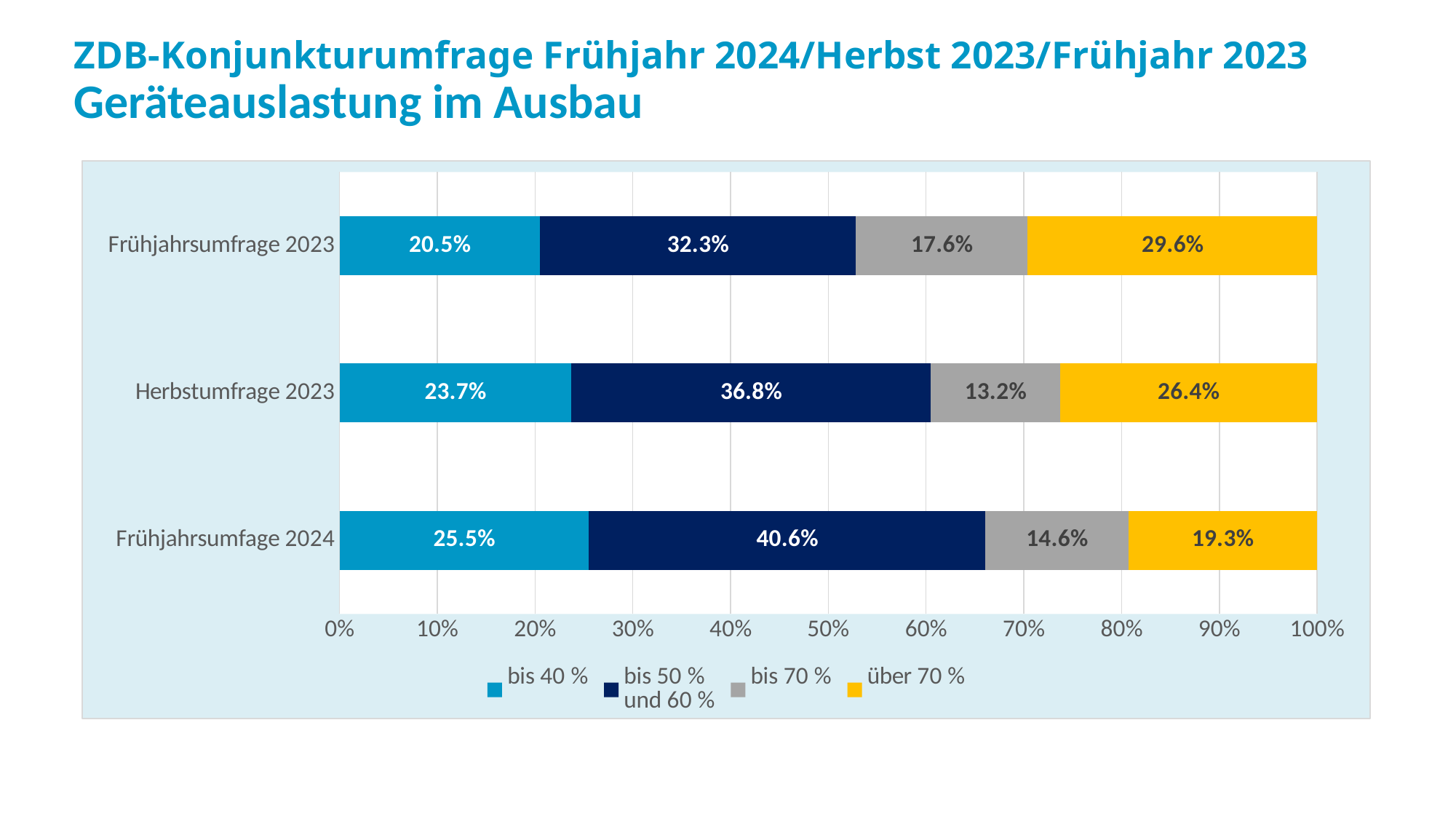
Which colour represents the 'über 70 %' series? Yellow How many surveys (bars) are shown in the chart? 3 What kind of chart is shown on the slide? Stacked bar chart What is the difference between the 'über 70 %' values for Frühjahrsumfrage 2023 and Frühjahrsumfage 2024? 10.3% Which is larger: the 'bis 40 %' value for Herbstumfrage 2023 or for Frühjahrsumfrage 2023? Herbstumfrage 2023 What is the value for 'bis 50 % und 60 %' in Herbstumfrage 2023? 36.8% What is the value for 'bis 70 %' in Herbstumfrage 2023? 13.2% What is the value for 'über 70 %' in Frühjahrsumfage 2024? 19.3% Which survey has the lowest value for 'über 70 %'? Frühjahrsumfage 2024 Which survey has the highest value for 'bis 50 % und 60 %'? Frühjahrsumfage 2024 What is the value for 'bis 40 %' in Frühjahrsumfrage 2023? 20.5% How many series does the legend list? 4